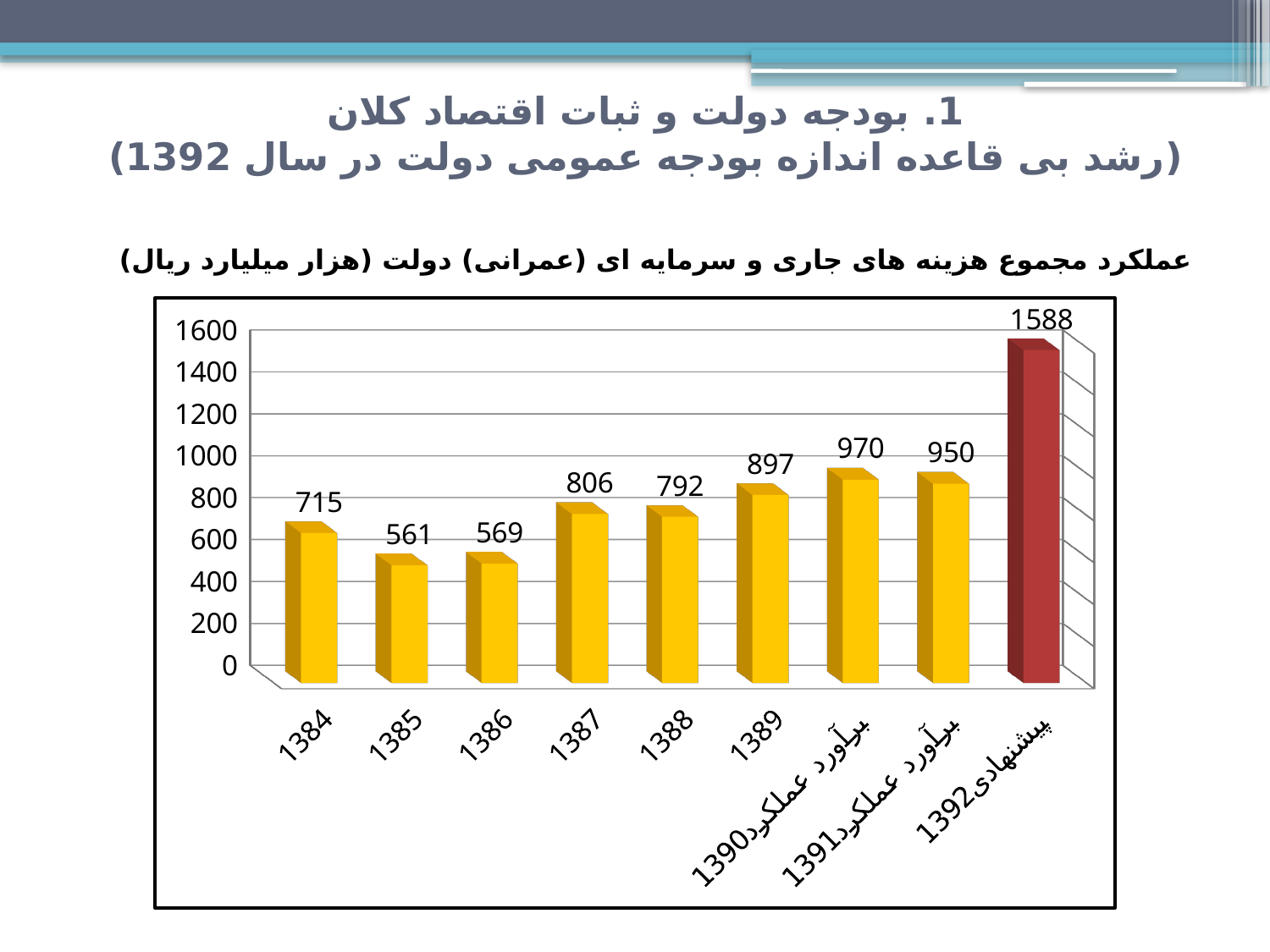
Which is larger, the value for 1387 or the value for 1388? 1387 Is the value for 1386 greater or less than 600? less How many categories are shown on the x axis? 9 Which category has the highest value? پیشنهادی 1392 What is the value for 1384? 715 What kind of chart is shown on the slide? bar chart What is the value for برآورد عملکرد 1391? 950 What colour is the bar for پیشنهادی 1392? red What is the difference between the values for پیشنهادی 1392 and برآورد عملکرد 1391? 638 What is the difference between the values for 1389 and 1388? 105 What is the value for 1387? 806 Which category has the lowest value? 1385